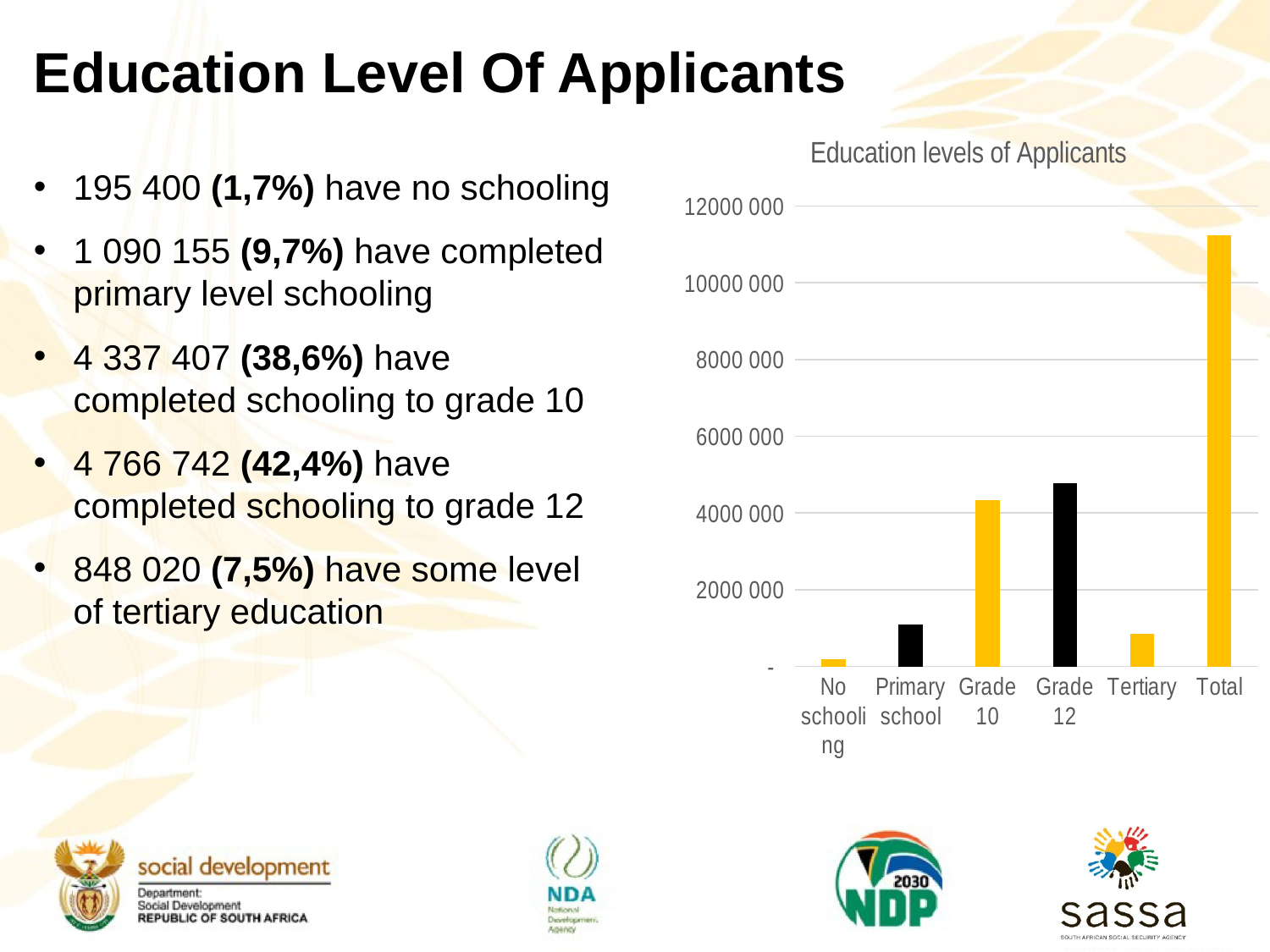
How many categories are shown on the x axis of the chart? 6 Is the value for Tertiary greater or less than 2000 000? less Excluding the Total bar, which education level has the highest value in the chart? Grade 12 Is the value for Grade 12 greater or less than 4000 000? greater What kind of chart is shown on the slide? bar chart Which category has the tallest bar in the chart? Total What is the title of the chart? Education levels of Applicants Which bar is taller in the chart, Primary school or Tertiary? Primary school Which bar is taller in the chart, Grade 12 or Grade 10? Grade 12 Is the value for Total greater or less than 10000 000? greater Which category has the shortest bar in the chart? No schooling